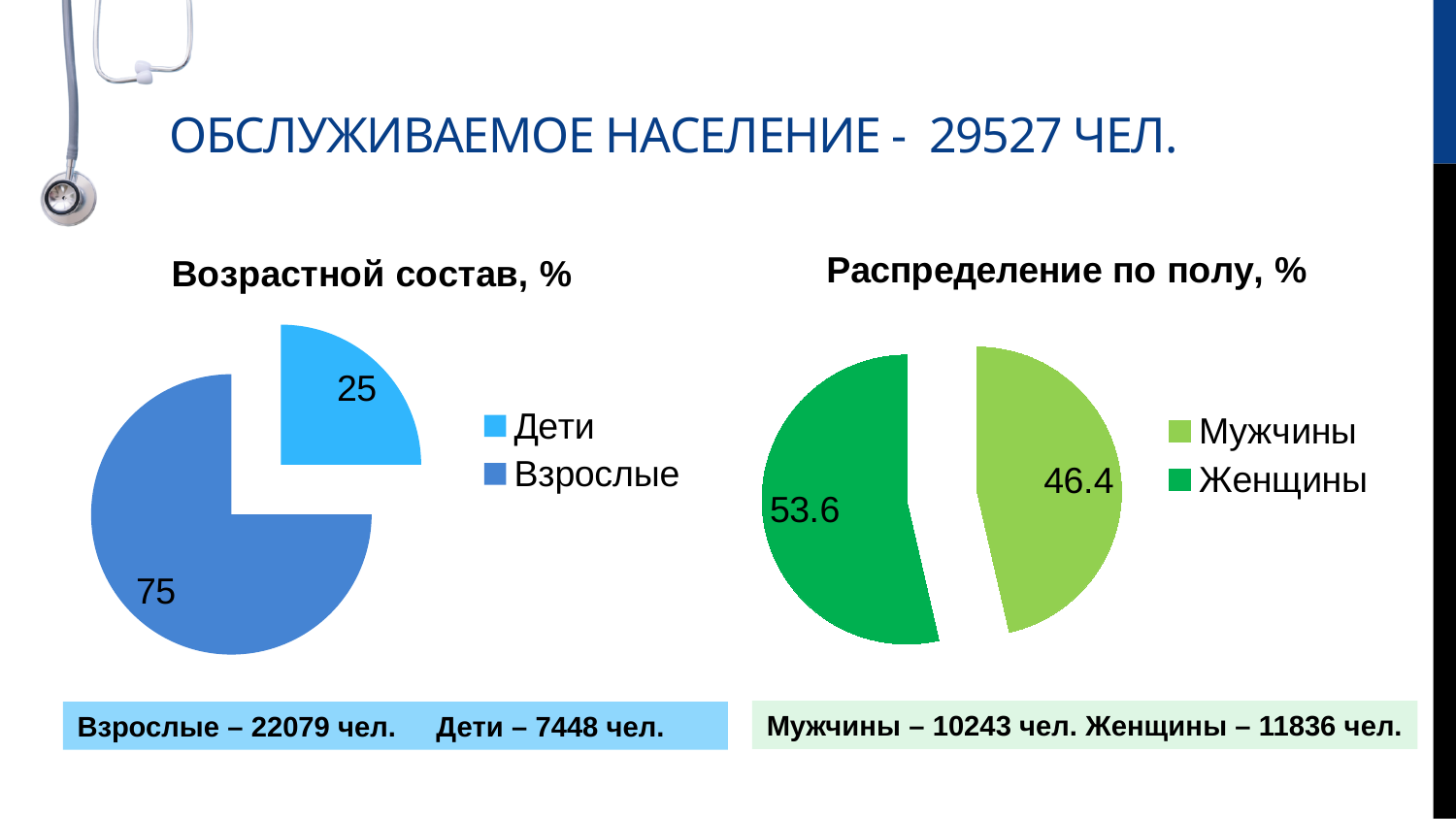
How many slices does the 'Распределение по полу, %' chart have? 2 In the 'Возрастной состав, %' chart, what is the value for Дети? 25 What kind of chart is the 'Возрастной состав, %' chart? Pie chart In the 'Возрастной состав, %' chart, which category has the largest slice? Взрослые In the 'Распределение по полу, %' chart, what is the value for Мужчины? 46.4 In the 'Распределение по полу, %' chart, what is the difference between the values for Женщины and Мужчины? 7.2 In the 'Возрастной состав, %' chart, what is the difference between the values for Взрослые and Дети? 50 In the 'Распределение по полу, %' chart, what is the value for Женщины? 53.6 In the 'Возрастной состав, %' chart, what colour is the Дети slice? Light blue In the 'Распределение по полу, %' chart, which is larger, Мужчины or Женщины? Женщины In the 'Возрастной состав, %' chart, what is the value for Взрослые? 75 In the 'Распределение по полу, %' chart, which category has the smallest slice? Мужчины